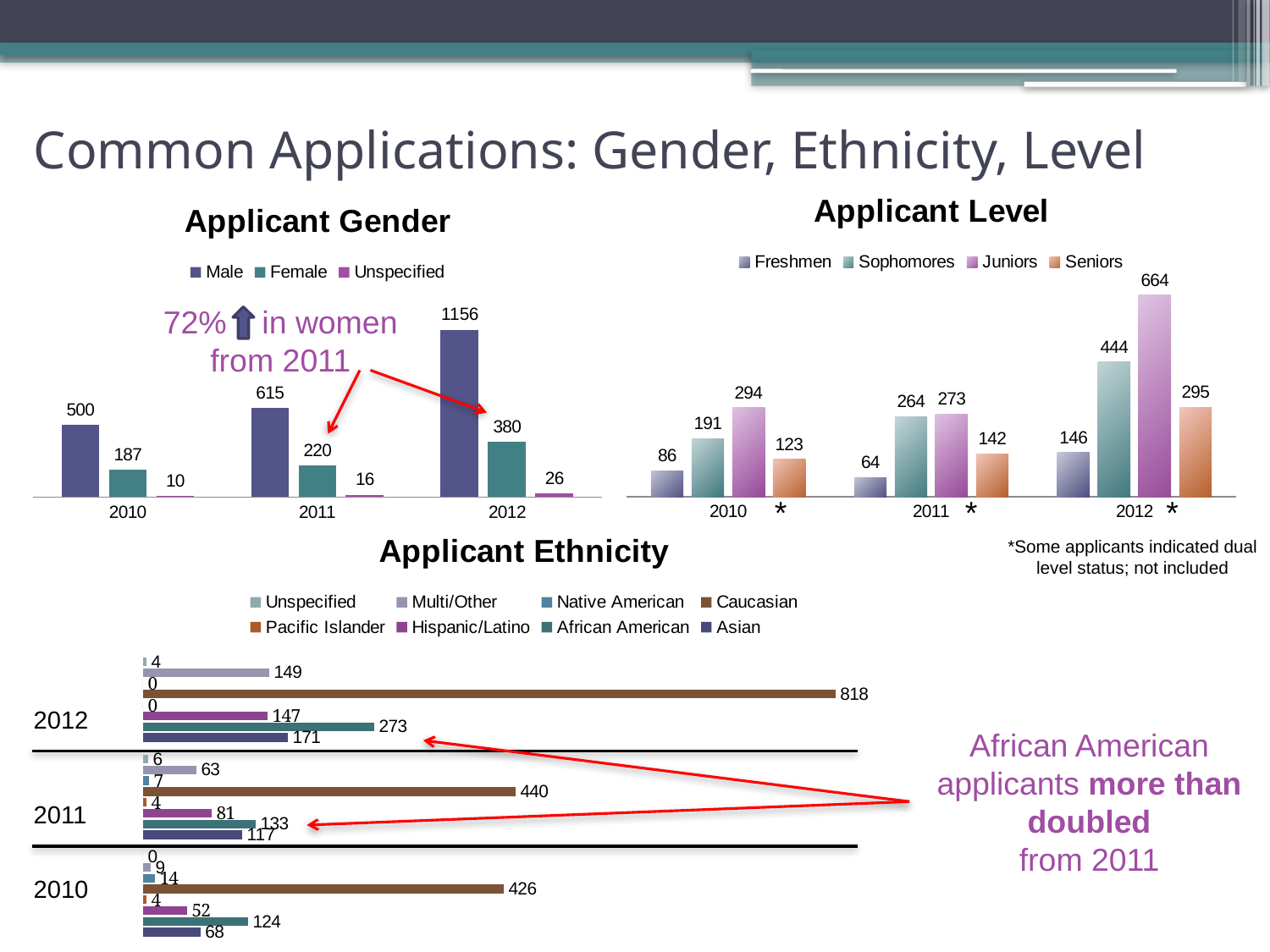
In the Applicant Gender chart, what is the value for Male in 2012? 1156 In the Applicant Level chart, which level has the highest value in 2012? Juniors In the Applicant Ethnicity chart, what is the value for African American in 2011? 133 What kind of chart is the Applicant Ethnicity chart? bar chart In the Applicant Level chart, do the Juniors values rise or fall from 2010 to 2012? rise In the Applicant Ethnicity chart, what is the value for Caucasian in 2012? 818 In the Applicant Gender chart, what is the difference between the Male and Female values in 2010? 313 In the Applicant Ethnicity chart, which is larger in 2010: Asian or Hispanic/Latino? Asian In the Applicant Level chart, which level has the lowest value in 2010? Freshmen In the Applicant Gender chart, what is the value for Female in 2011? 220 In the Applicant Level chart, what is the value for Sophomores in 2011? 264 In the Applicant Gender chart, how many series does the legend list? 3